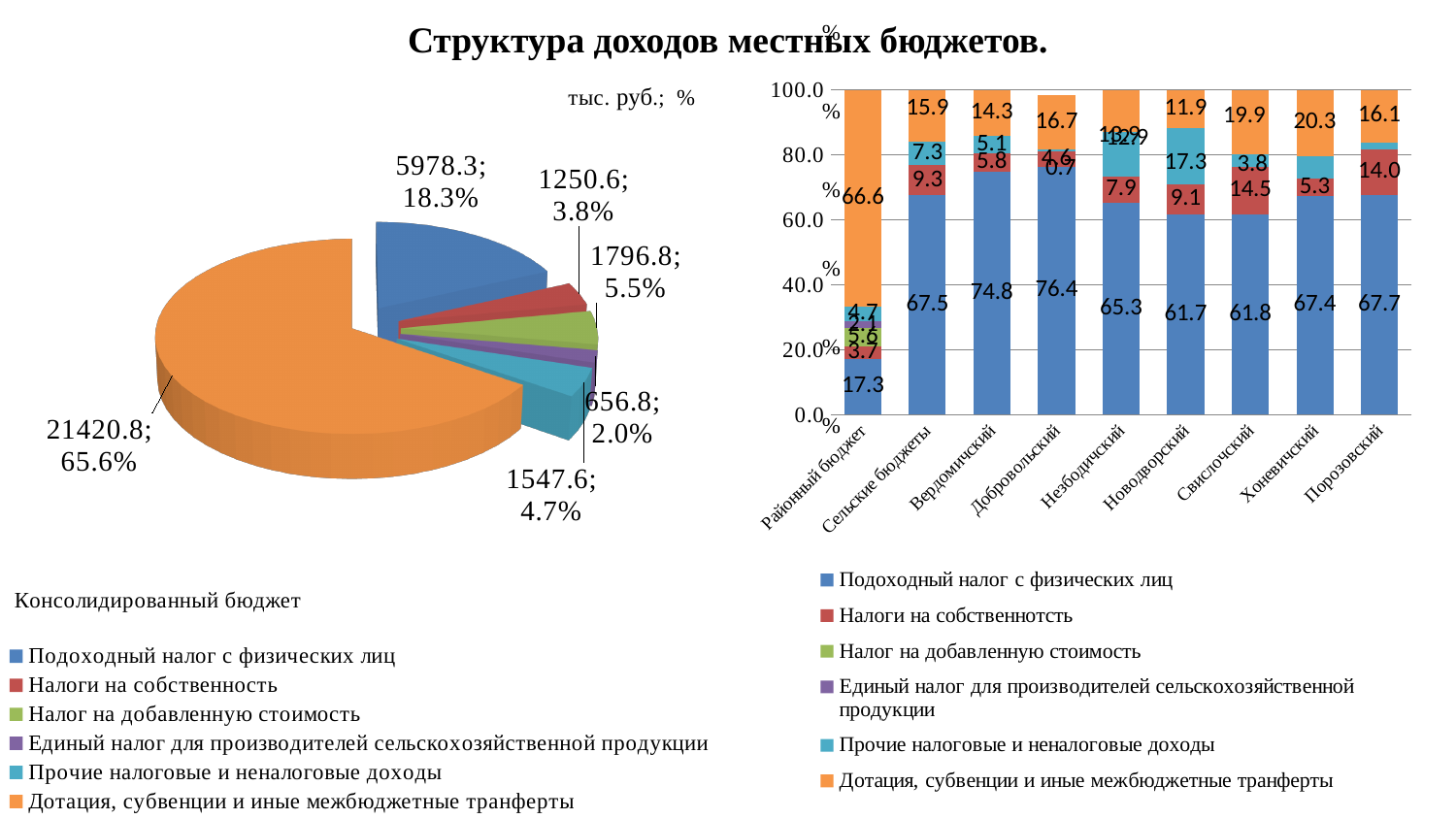
How many categories are shown on the x axis of the bar chart on the right? 9 In the pie chart on the left, what share does the slice for Дотация, субвенции и иные межбюджетные транферты have? 65.6% In the bar chart on the right, which category has the highest value for Подоходный налог с физических лиц? Добровольский How many series does the legend of the bar chart on the right list? 6 In the pie chart on the left, what value is shown for Подоходный налог с физических лиц? 5978.3; 18.3% In the bar chart on the right, what is the value of Подоходный налог с физических лиц for Добровольский? 76.4 What kind of chart is the chart on the right of the slide? bar chart In the bar chart on the right, what is the value of Дотация, субвенции и иные межбюджетные транферты for Районный бюджет? 66.6 In the pie chart on the left, which is larger: the slice for Налог на добавленную стоимость or the slice for Налоги на собственность? Налог на добавленную стоимость In the bar chart on the right, what is the difference between the Подоходный налог с физических лиц values for Вердомичский and Новодворский? 13.1 In the pie chart on the left, which category has the smallest slice? Единый налог для производителей сельскохозяйственной продукции What kind of chart is the chart on the left of the slide? pie chart